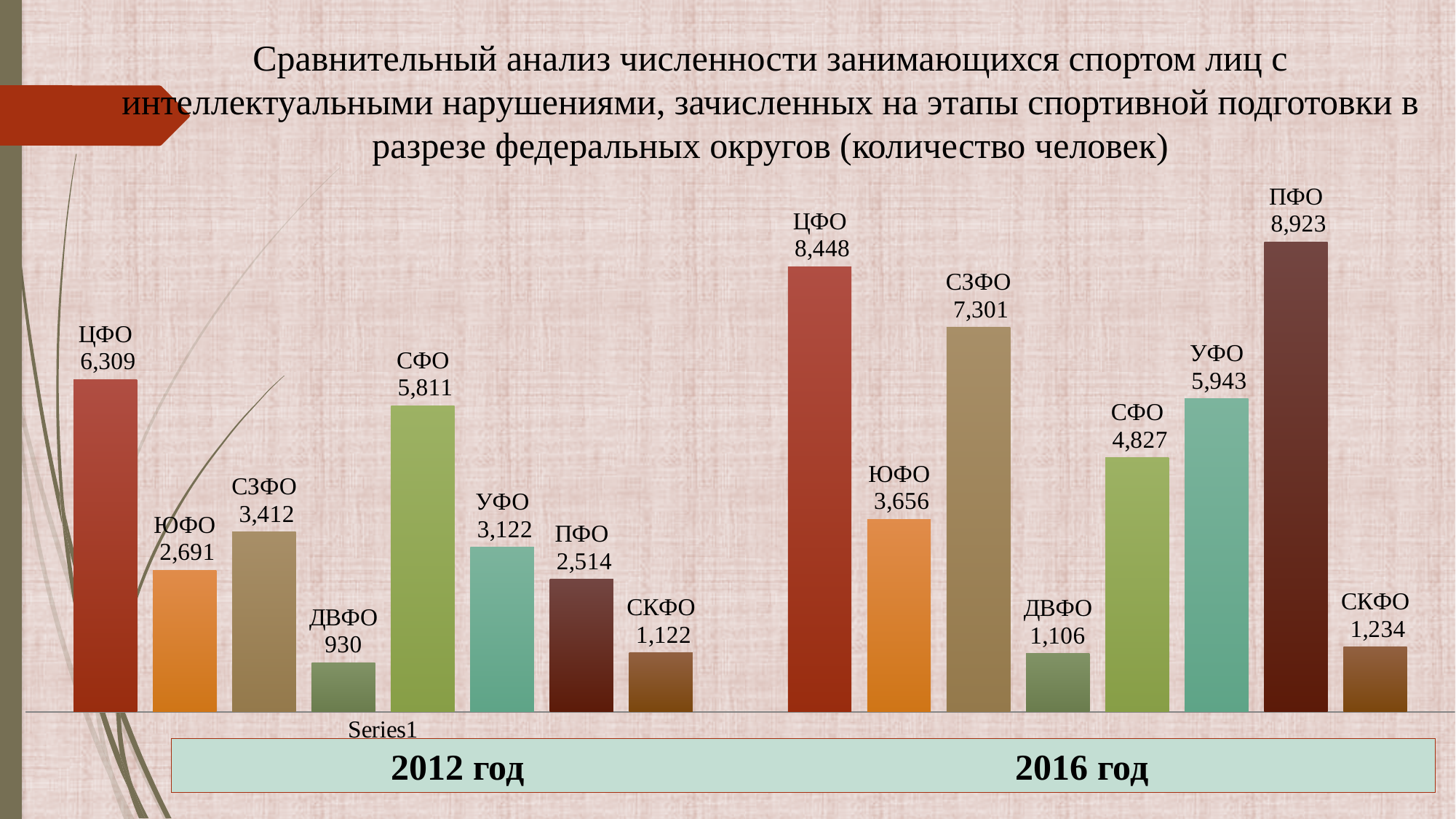
Which is larger: the value for СФО in 2012 or the value for СФО in 2016? СФО in 2012 What is the value for ДВФО in 2012? 930 What is the value for ПФО in 2016? 8,923 What is the value for ЦФО in 2012? 6,309 What is the difference between the ПФО values in 2016 and 2012? 6,409 Which federal district has the highest value in 2016? ПФО What is the difference between the ЦФО values in 2016 and 2012? 2,139 What is the value for СЗФО in 2016? 7,301 How many federal districts are shown for each year? 8 Which federal district has the lowest value in 2012? ДВФО What kind of chart is shown on the slide? Bar chart Which two years are compared in the chart? 2012 and 2016